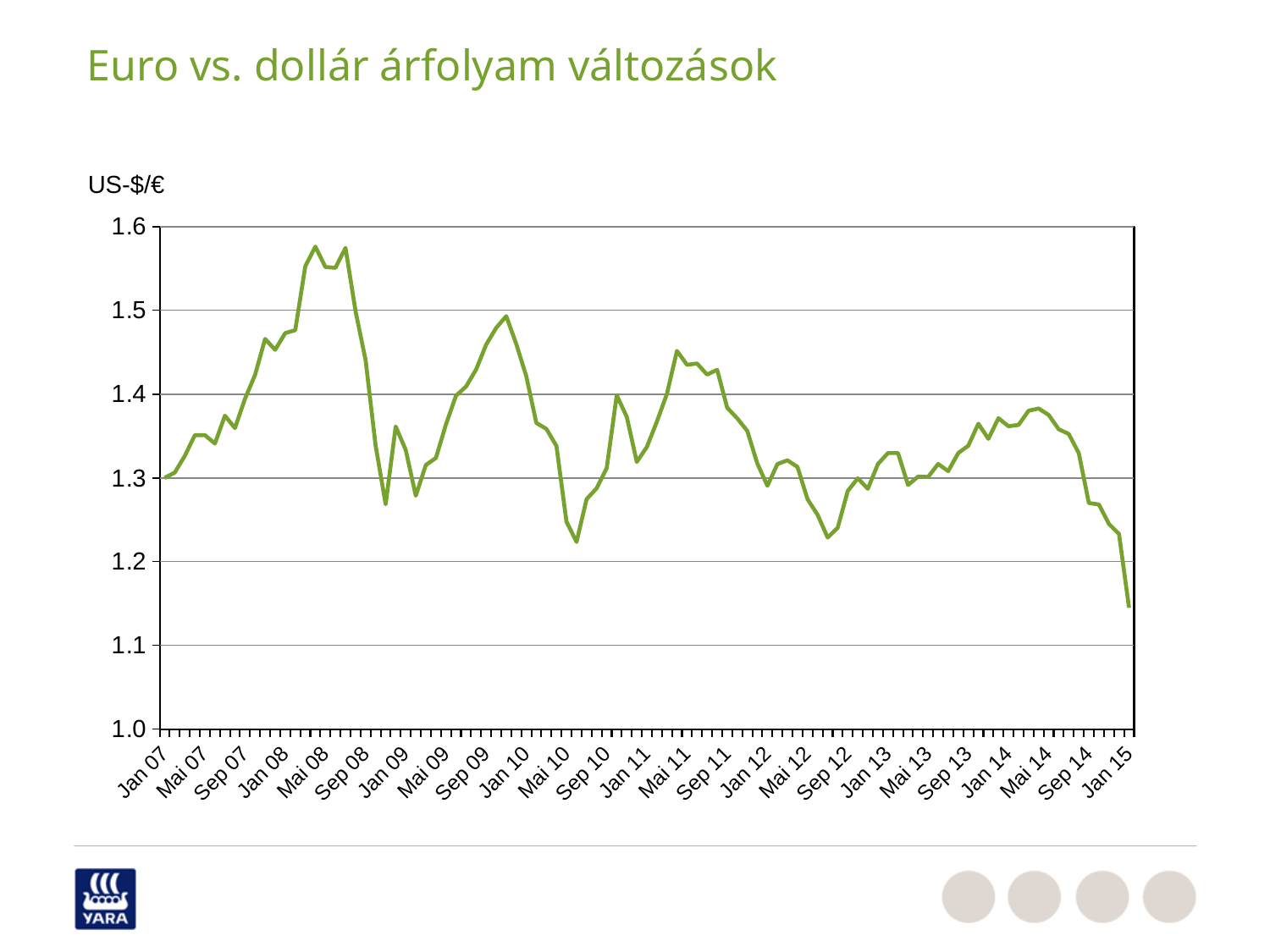
Does the line rise or fall between Sep 14 and Jan 15? fall Is the value for Mai 11 greater or less than 1.4? greater Is the value for Jan 15 greater or less than 1.2? less What kind of chart is shown on the slide? line chart Is the value for Jan 14 greater or less than 1.4? less In which year does the line reach its highest value? 2008 What unit label is shown above the vertical axis of the chart? US-$/€ What is the title of the chart on the slide? Euro vs. dollár árfolyam változások At which x-axis label does the line reach its lowest value? Jan 15